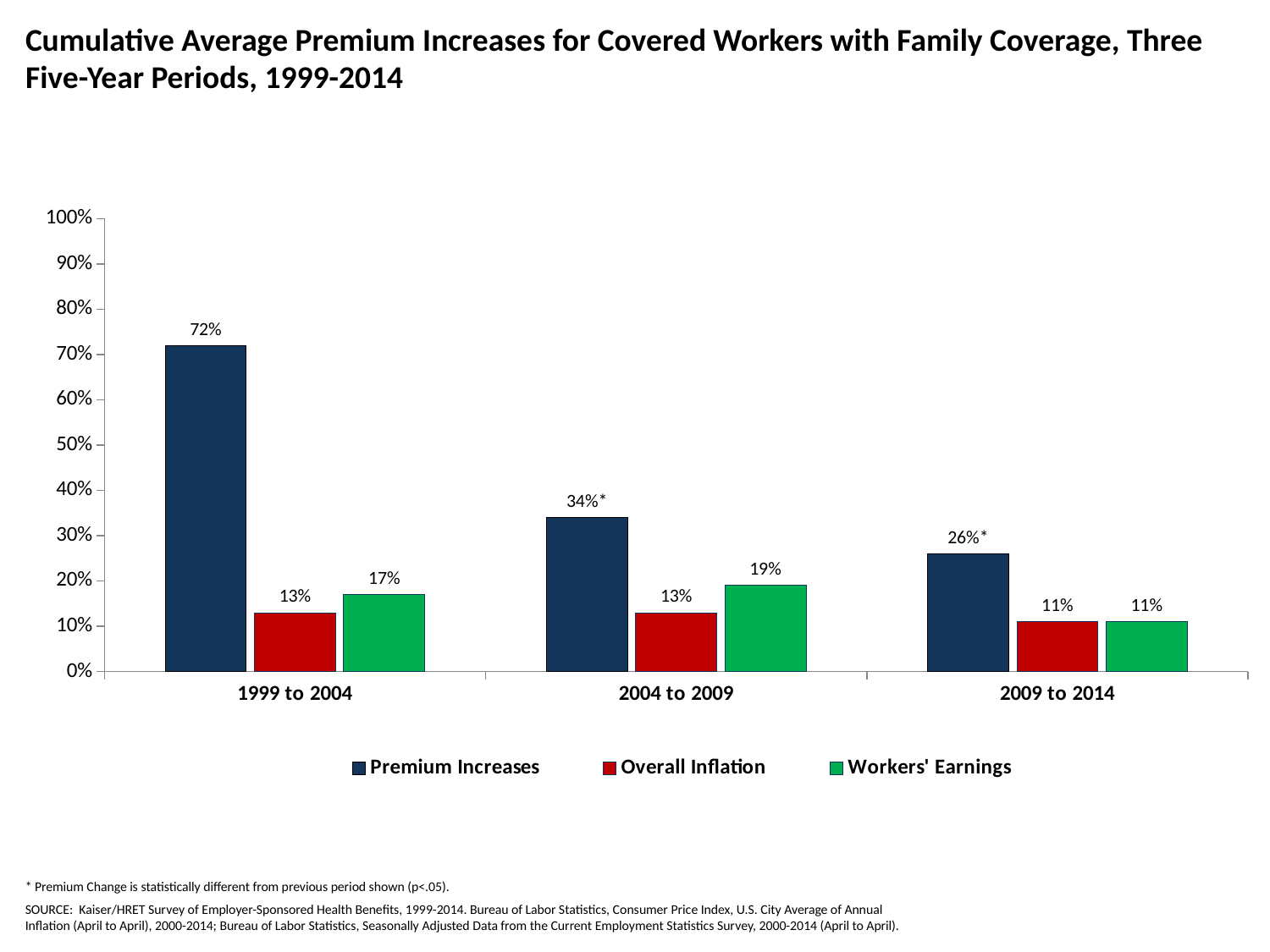
Do the Premium Increases values rise or fall across the periods from 1999 to 2004 through 2009 to 2014? fall How many series does the legend list? 3 How many periods are shown on the x axis? 3 What is the Premium Increases value for 1999 to 2004? 72% Which period has the lowest Workers' Earnings value? 2009 to 2014 What is the Overall Inflation value for 2009 to 2014? 11% Which period has the highest Premium Increases value? 1999 to 2004 What is the Workers' Earnings value for 2004 to 2009? 19% What is the difference between Premium Increases and Overall Inflation for 1999 to 2004? 59% What is the difference between Premium Increases for 2004 to 2009 and 2009 to 2014? 8% Which is larger for 2004 to 2009: Overall Inflation or Workers' Earnings? Workers' Earnings What kind of chart is shown? bar chart